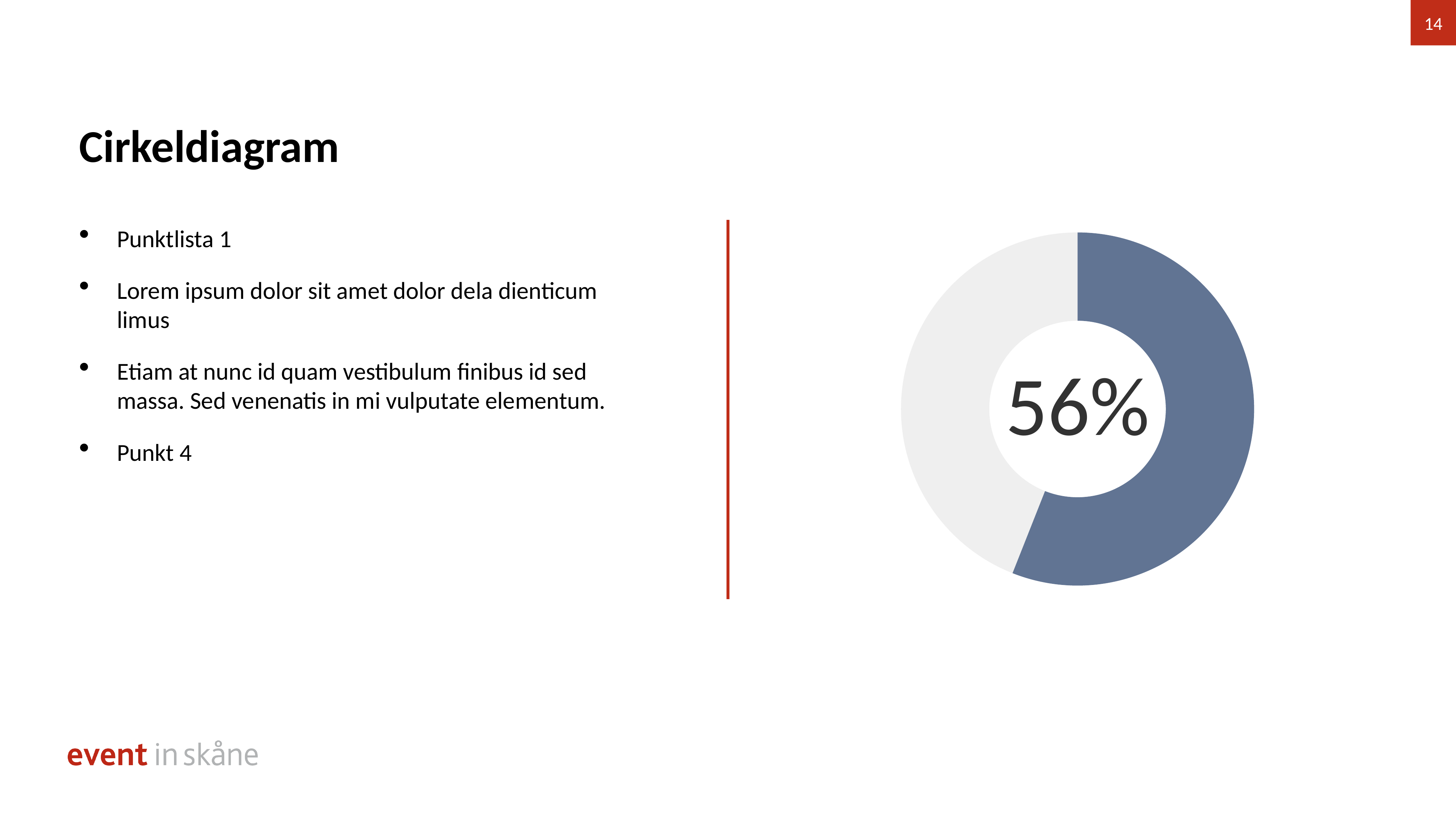
Which slice of the donut chart is larger, the blue one or the grey one? The blue one What percentage is printed in the centre of the donut chart? 56% Is the blue slice of the donut chart greater or less than 50% of the whole? greater What share of the donut chart does the blue slice represent? 56% How many slices does the donut chart have? 2 What kind of chart is shown on the slide? Donut (pie) chart What is the title of the slide containing the donut chart? Cirkeldiagram Which slice of the donut chart is the smallest? The grey slice What colour is the larger slice of the donut chart? Blue